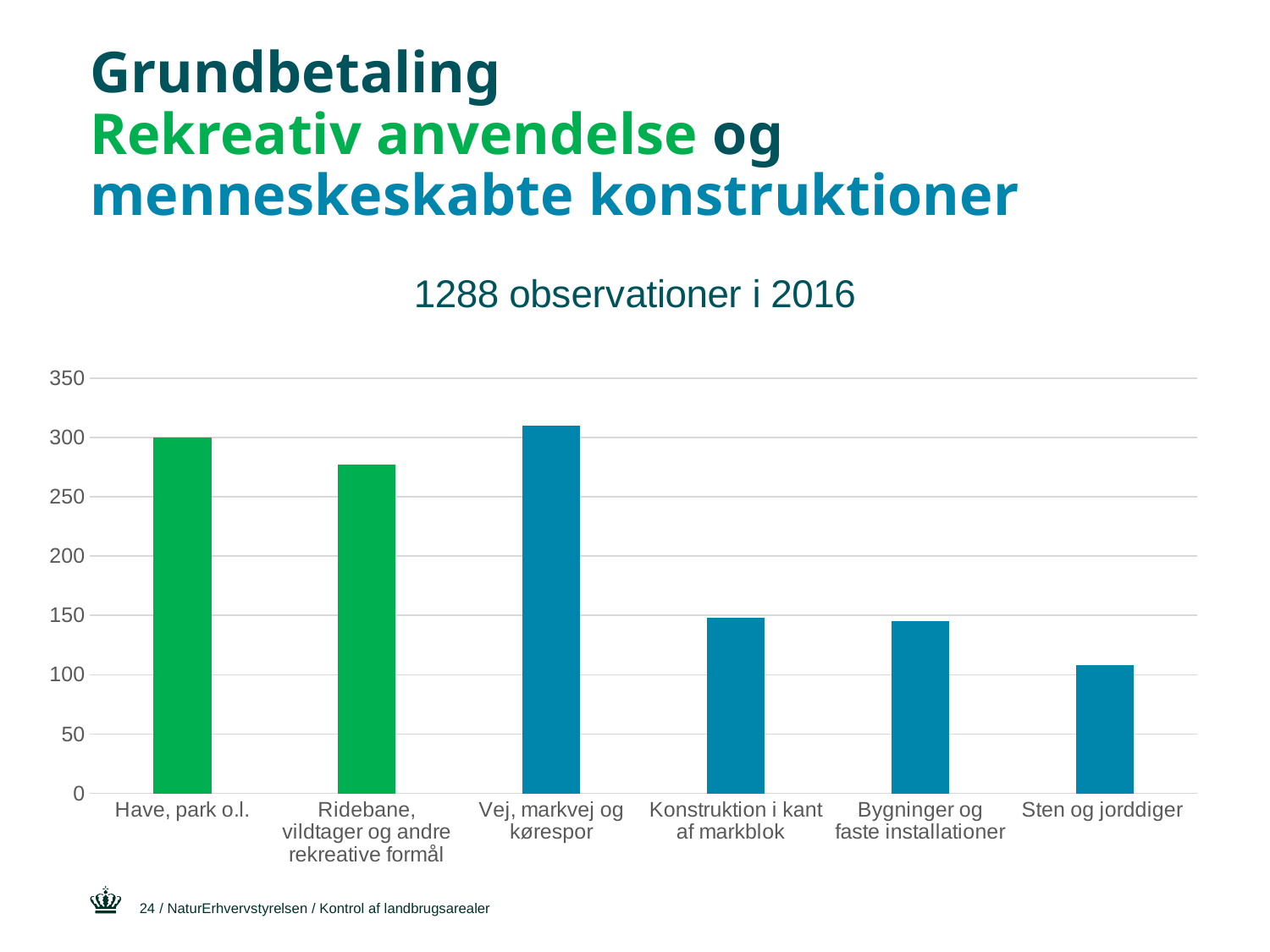
Which category has the highest value in the chart? Vej, markvej og kørespor Is the value for Sten og jorddiger greater or less than 100? greater What is the title shown above the chart? 1288 observationer i 2016 Is the value for Vej, markvej og kørespor greater or less than 300? greater Which category has the lowest value in the chart? Sten og jorddiger What kind of chart is shown on the slide? bar chart Which is larger, the value for Ridebane, vildtager og andre rekreative formål or the value for Konstruktion i kant af markblok? Ridebane, vildtager og andre rekreative formål Is the value for Ridebane, vildtager og andre rekreative formål greater or less than 250? greater How many categories are shown on the x axis of the chart? 6 Which is larger, the value for Have, park o.l. or the value for Sten og jorddiger? Have, park o.l.